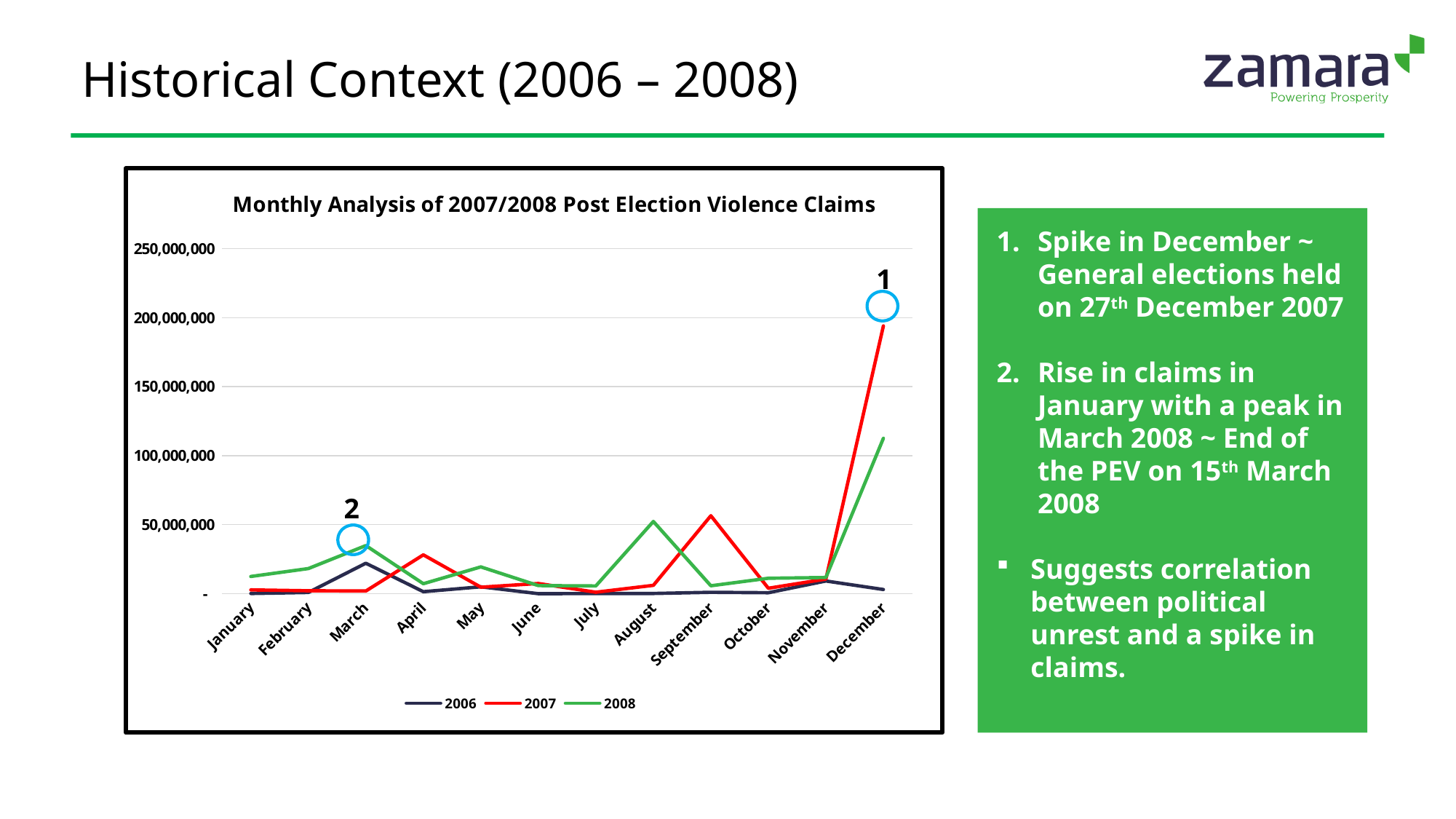
In which month does the 2008 series reach its highest value? December Is the value for 2008 in December greater or less than 100,000,000? greater How many months are plotted along the x axis? 12 Is the value for 2006 in March greater or less than 50,000,000? less Is the value for 2007 in December greater or less than 150,000,000? greater In which month does the 2007 series reach its highest value? December What kind of chart is shown on the slide? Line chart Does the 2007 series rise or fall from November to December? Rise How many series does the legend list? 3 Which series has the larger value in December, 2007 or 2008? 2007 What is the title of the chart? Monthly Analysis of 2007/2008 Post Election Violence Claims